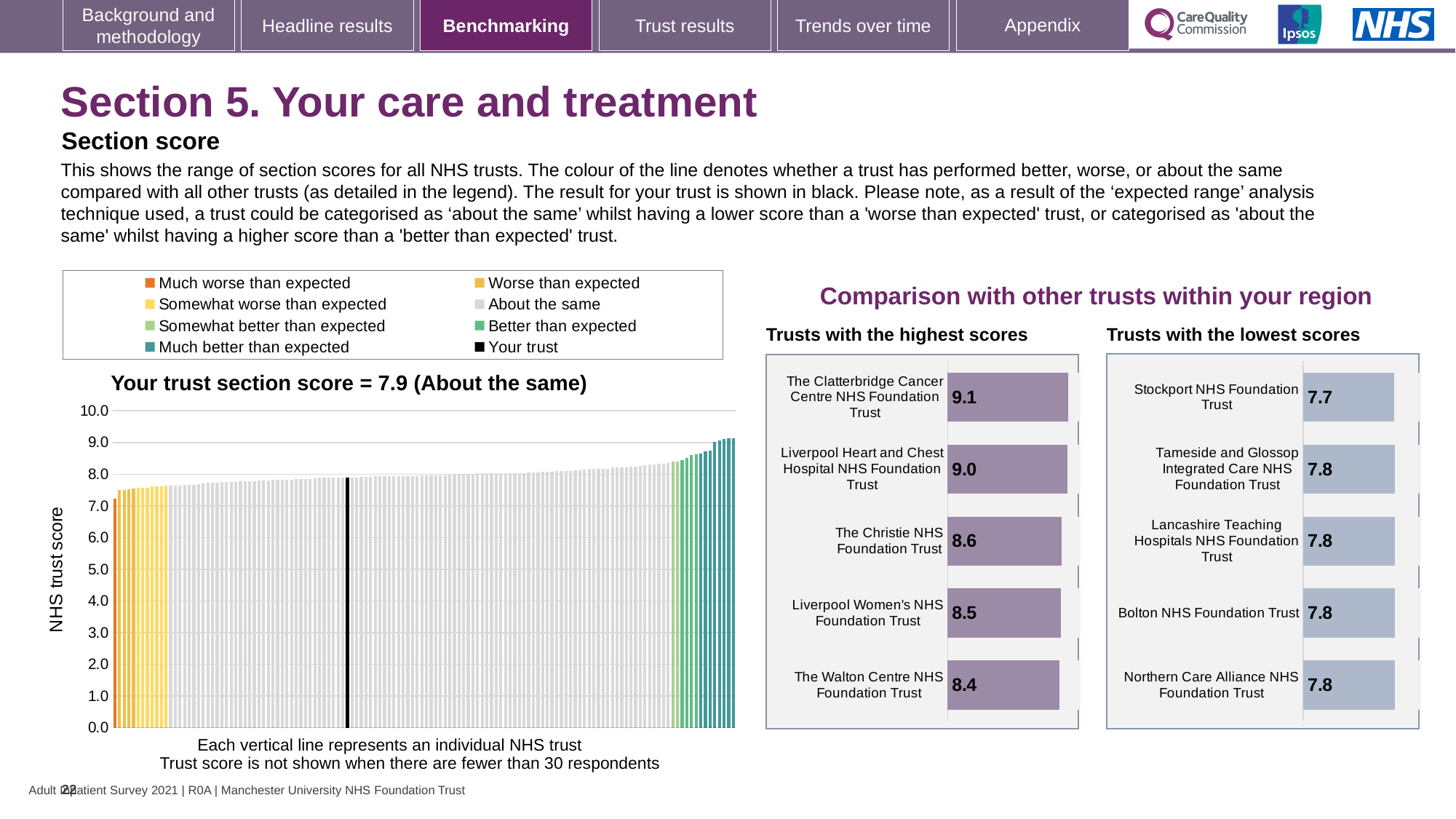
In the 'Your trust section score' chart on the left, do the bar values rise or fall from left to right? rise In the 'Trusts with the highest scores' chart, what is the difference between the scores of The Clatterbridge Cancer Centre NHS Foundation Trust and The Walton Centre NHS Foundation Trust? 0.7 In the 'Trusts with the highest scores' chart, what is the score for The Walton Centre NHS Foundation Trust? 8.4 In the 'Trusts with the highest scores' chart, what is the score for The Clatterbridge Cancer Centre NHS Foundation Trust? 9.1 How many trusts are listed in the 'Trusts with the lowest scores' chart? 5 In the 'Trusts with the highest scores' chart, which has the higher score: The Christie NHS Foundation Trust or Liverpool Women's NHS Foundation Trust? The Christie NHS Foundation Trust In the 'Your trust section score' chart on the left, what is the section score for your trust? 7.9 How many entries does the legend above the 'Your trust section score' chart list? 8 In the 'Trusts with the lowest scores' chart, which trust has the lowest score? Stockport NHS Foundation Trust In the 'Trusts with the lowest scores' chart, what is the score for Stockport NHS Foundation Trust? 7.7 In the 'Trusts with the highest scores' chart, which trust has the highest score? The Clatterbridge Cancer Centre NHS Foundation Trust In the 'Your trust section score' chart on the left, is the value of the leftmost (lowest) bar greater or less than 8.0? less